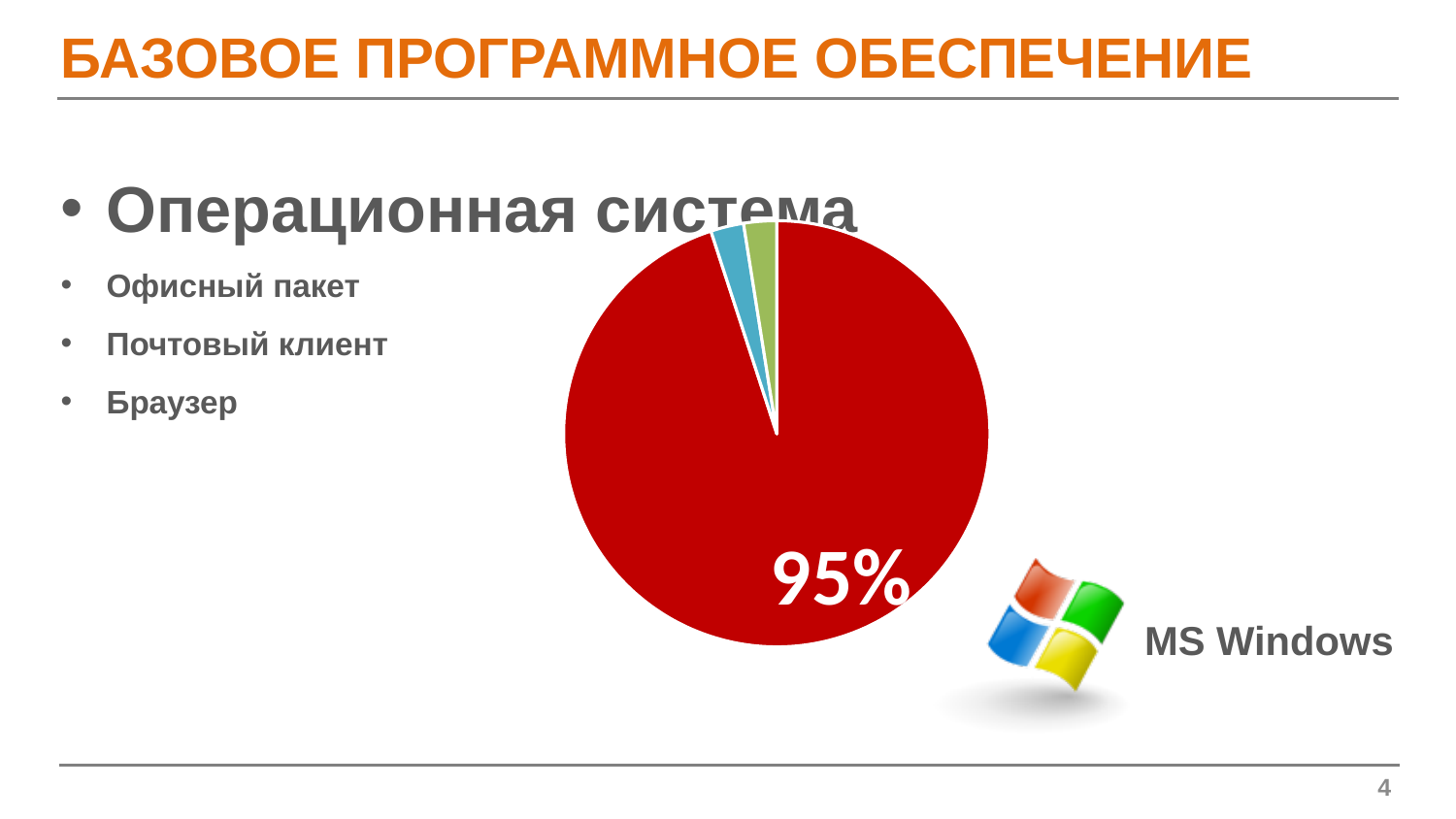
What share of the pie does the red slice represent? 95% What percentage is printed on the large red slice of the pie chart? 95% Which slice of the pie chart is the largest? the red slice (95%) How many slices does the pie chart have? 3 What software name is shown next to the pie chart? MS Windows What kind of chart is shown on the slide? pie chart Which is larger in the pie chart, the green slice or the red slice? the red slice Which is larger in the pie chart, the red slice or the blue slice? the red slice What colour is the slice labelled 95% in the pie chart? red